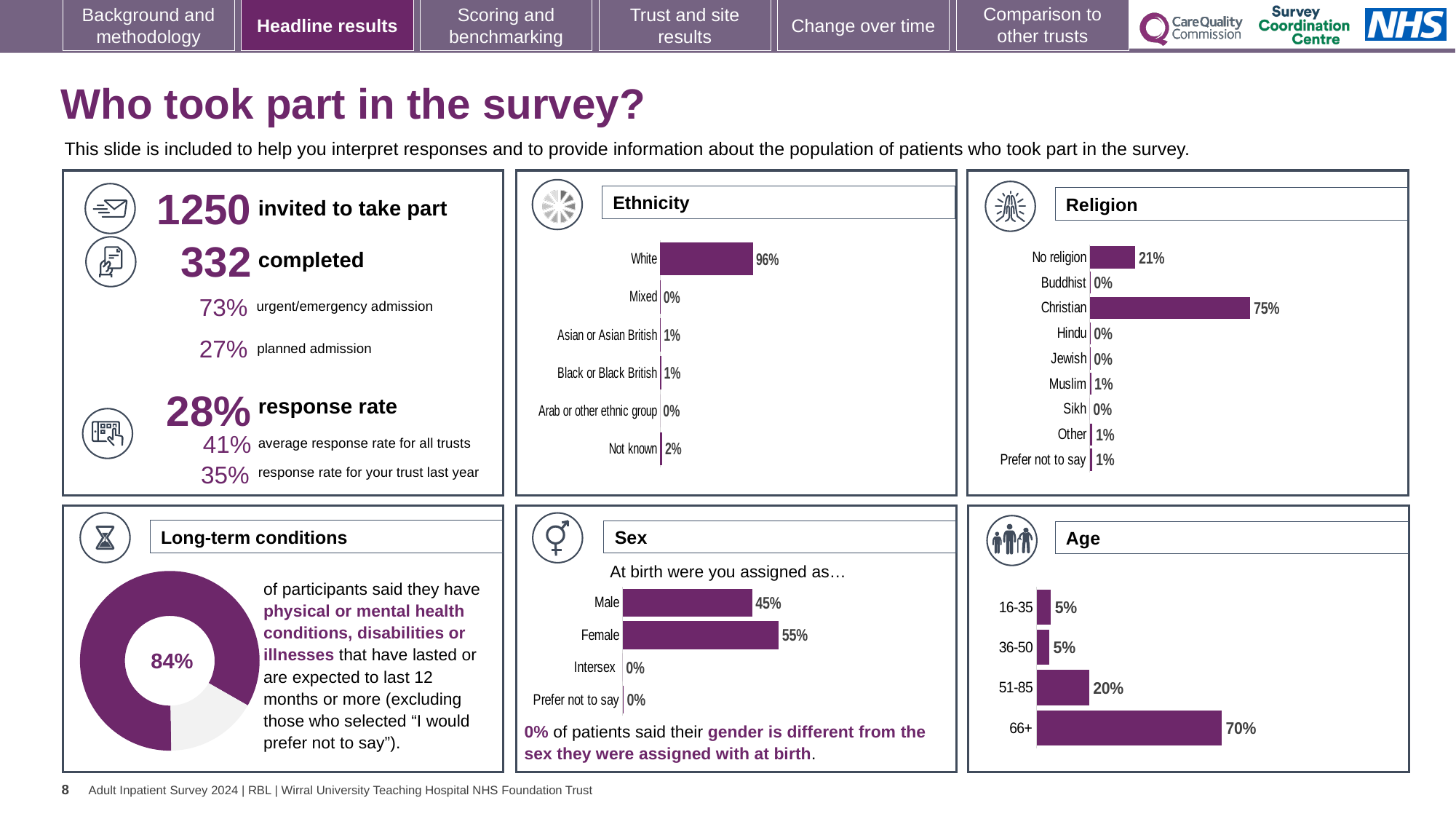
In the Ethnicity chart, what is the value for Not known? 2% In the Age chart, do the values rise or fall as age increases from 16-35 to 66+? rise In the Religion chart, what percentage of respondents were Christian? 75% In the Age chart, what percentage of respondents were aged 66+? 70% What kind of chart is used in the Long-term conditions panel? doughnut chart In the Ethnicity chart, what percentage of respondents were White? 96% How many categories are shown in the Religion chart? 9 In the Religion chart, what is the difference between the Christian and No religion values? 54% In the Ethnicity chart, which category has the highest value? White In the Sex chart, what is the difference between the Female and Male values? 10% In the Sex chart, which is larger, Male or Female? Female In the Long-term conditions chart, what share of participants said they have a long-term condition? 84%